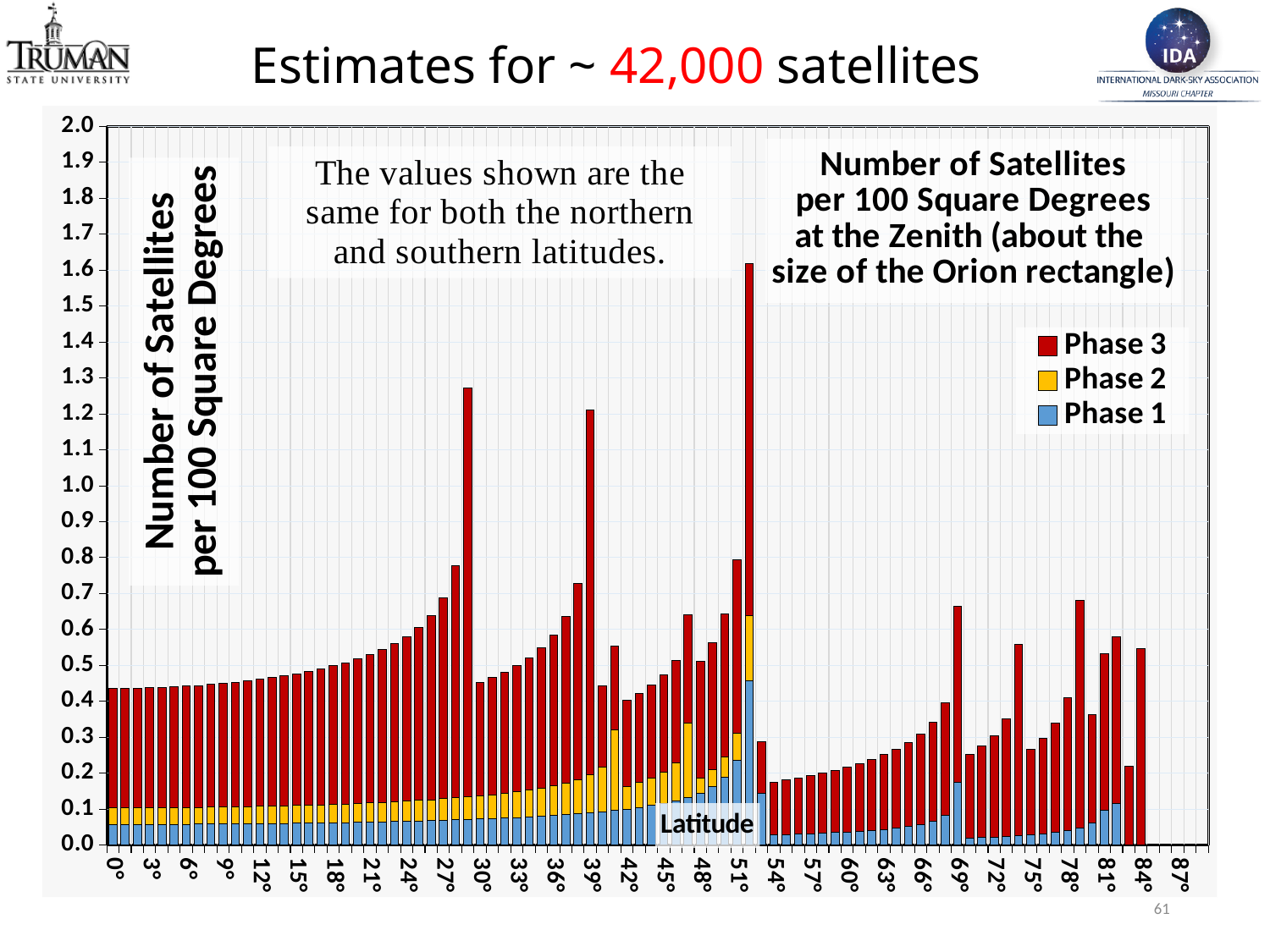
Which phase contributes the largest portion of the bar at 0° latitude? Phase 3 What is the label on the x axis of the chart? Latitude Is the tallest bar in the chart greater or less than 1.5? greater How many series does the legend list? 3 Is the total value for 60° latitude greater or less than 0.3? less What is the highest value shown on the y axis? 2.0 Is the total value for 84° latitude greater or less than 0.4? greater Do the total values rise or fall along the x axis from 0° to 24° latitude? rise What kind of chart is shown on the slide? Stacked bar chart What are the three series named in the legend? Phase 3, Phase 2, Phase 1 Which has the larger total value, 0° latitude or 60° latitude? 0°